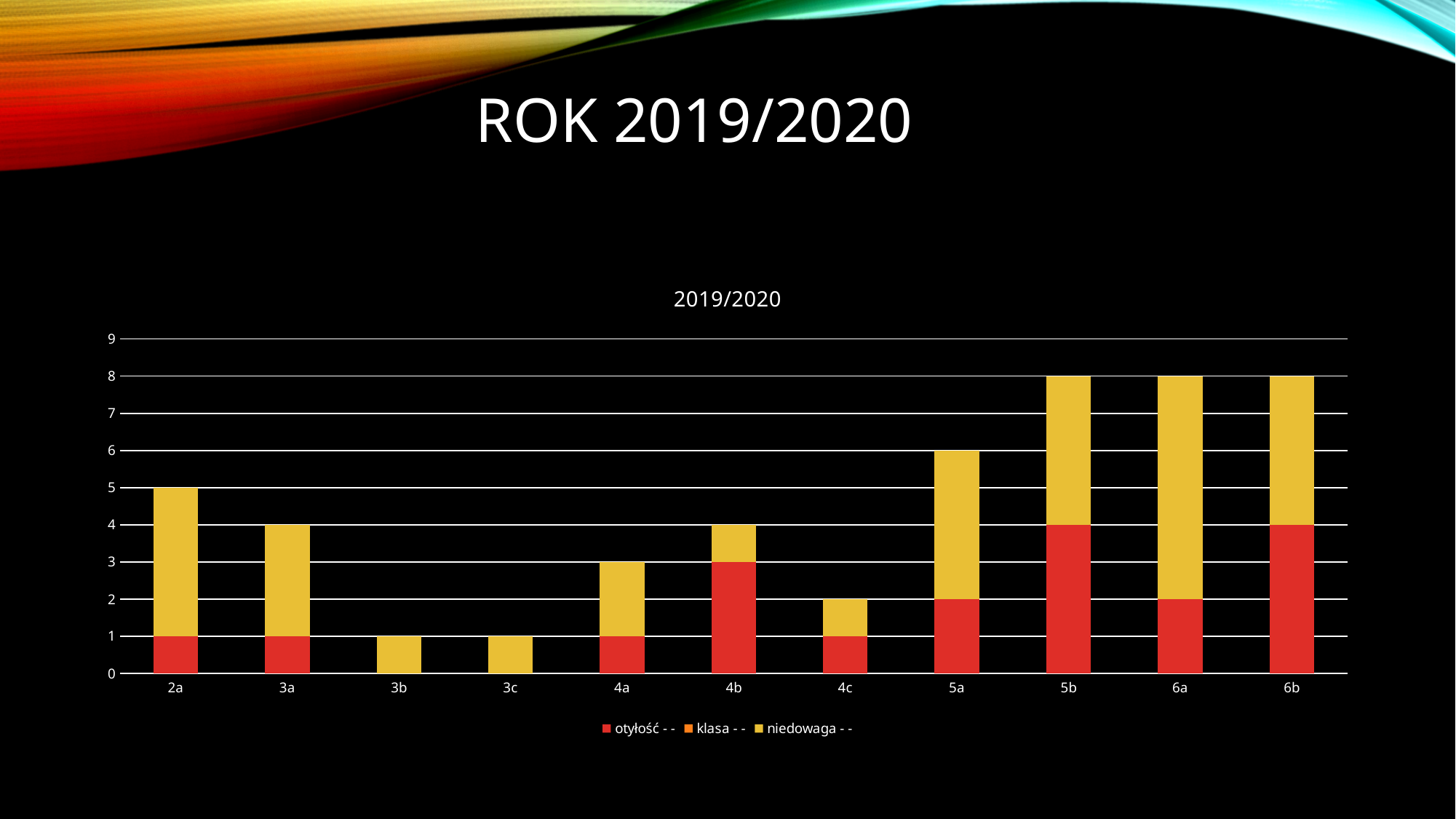
How many series does the chart legend list? 3 Is the total value for class 5b greater or less than 7? greater What is the total height of the stacked bar for class 5a? 6 Which class has the larger otyłość (red) value, 4b or 5a? 4b How many classes (categories) are shown on the x axis of the chart? 11 What is the value of otyłość (red segment) for class 4b? 3 What kind of chart is shown on the slide? stacked bar chart Which stacked bar is taller, class 2a or class 3a? 2a What is the difference between the total for class 5a and the total for class 2a? 1 What is the value of niedowaga (yellow segment) for class 6a? 6 Which class has the highest niedowaga (yellow) value? 6a What is the title shown above the chart? 2019/2020